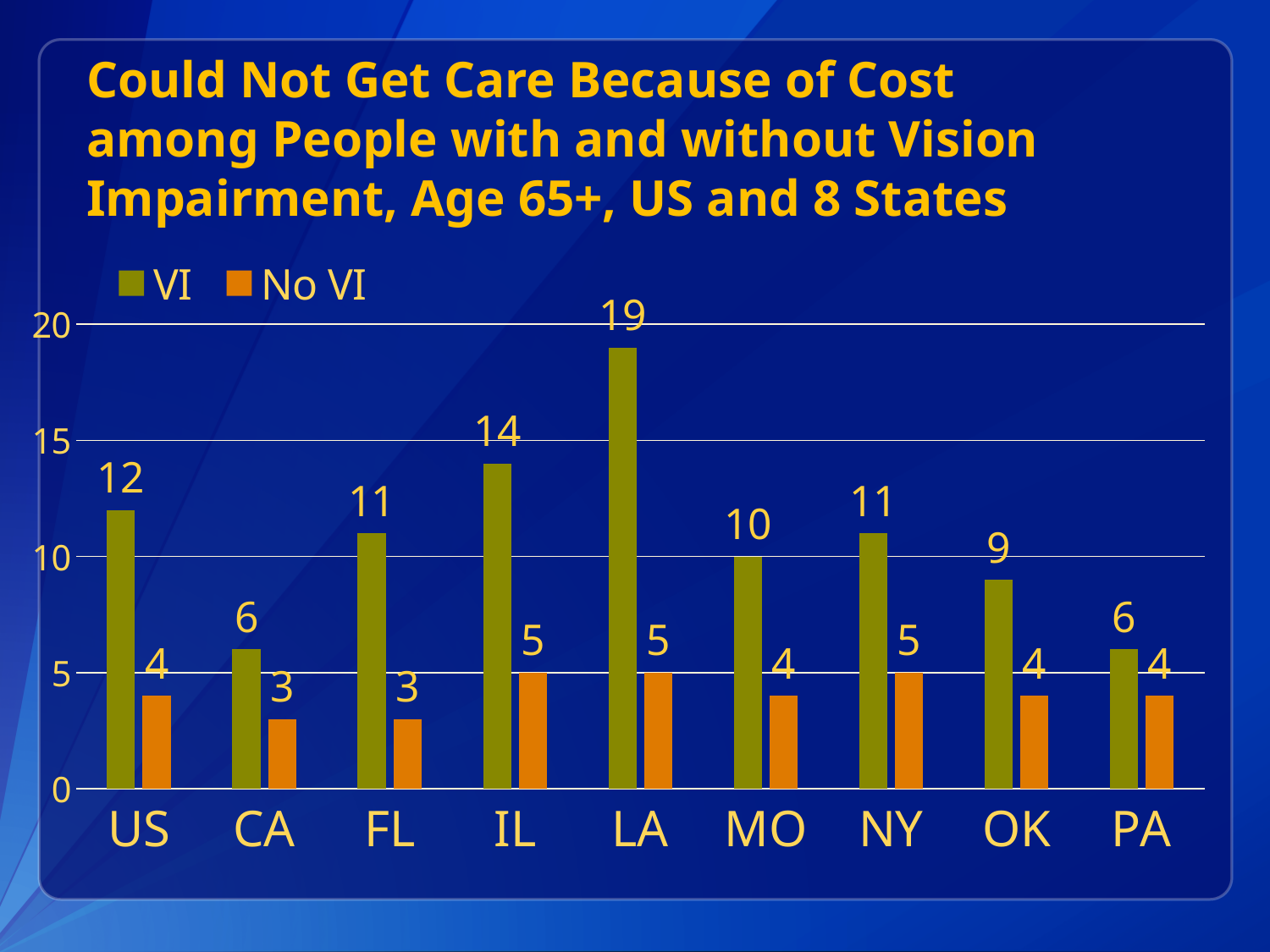
How many categories are shown on the x axis? 9 Which category has the highest VI value? LA What kind of chart is shown on the slide? Bar chart What is the difference between the VI and No VI values for LA? 14 What is the VI value for LA? 19 Is the VI value for OK greater or less than 5? greater Which is larger, the VI value for IL or the VI value for NY? IL What is the No VI value for IL? 5 What is the VI value for US? 12 Which colour represents the No VI series? Orange How many series does the legend list? 2 Which categories have the lowest No VI value? CA and FL